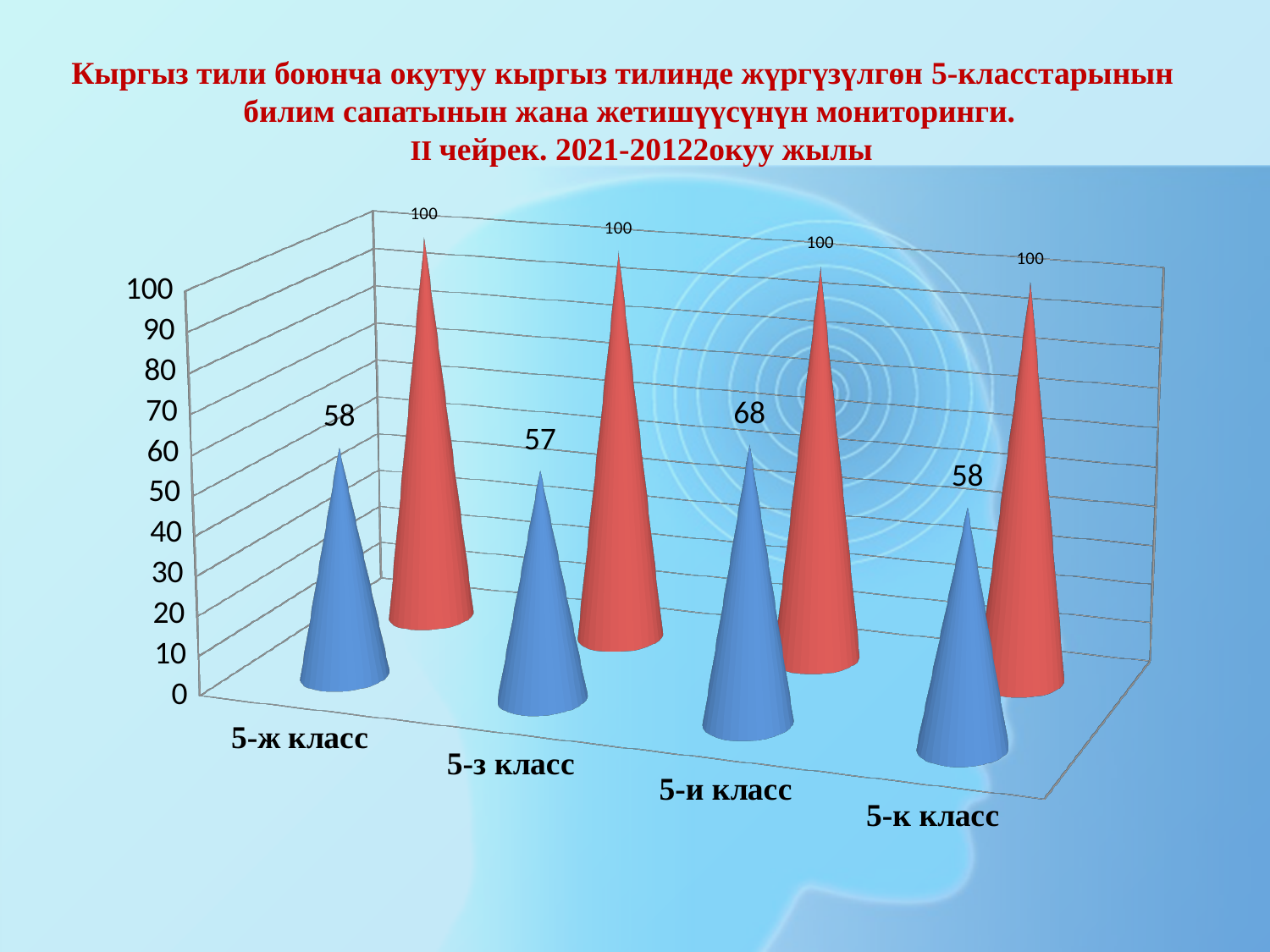
What colour are the bars that all have the value 100? red What is the value of the blue bar for 5-и класс? 68 Which class has the highest blue bar value? 5-и класс What is the value of the blue bar for 5-к класс? 58 Which is larger: the blue bar value for 5-и класс or for 5-ж класс? 5-и класс Which class has the lowest blue bar value? 5-з класс What is the value of the red bar for 5-ж класс? 100 What kind of chart is shown on the slide? bar chart What is the difference between the red and blue bar values for 5-к класс? 42 What is the value of the blue bar for 5-з класс? 57 What is the difference between the blue bar values for 5-и класс and 5-з класс? 11 How many classes are shown on the x axis? 4